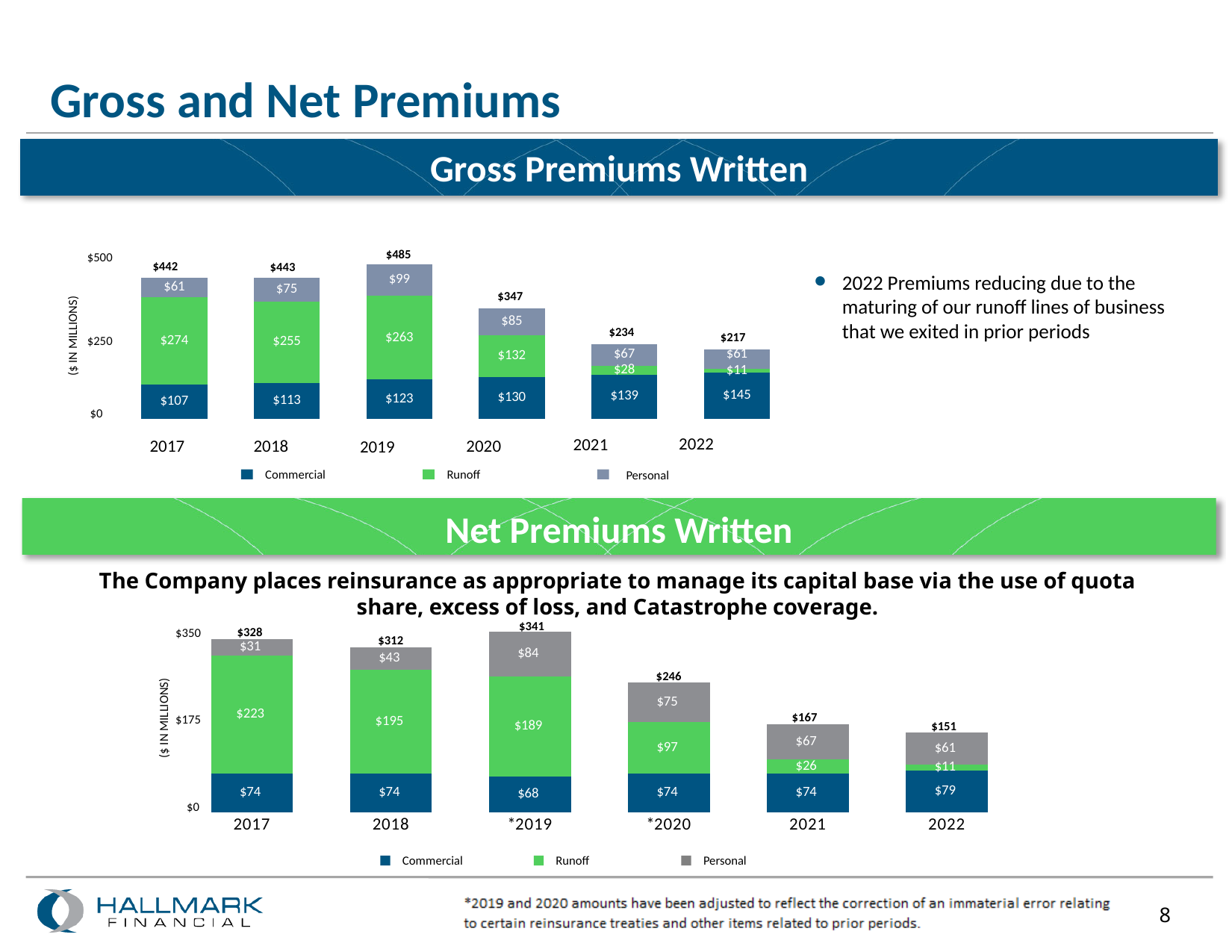
In the Gross Premiums Written chart, what is the Commercial value for 2019? $123 In the Gross Premiums Written chart, how many years are shown on the x axis? 6 In the Gross Premiums Written chart, do the bar totals rise or fall from 2019 to 2022? Fall In the Net Premiums Written chart, what is the Personal value for *2019? $84 In the Net Premiums Written chart, which year has the lowest total? 2022 In the Net Premiums Written chart, what is the total of the stacked bar for 2021? $167 In the Net Premiums Written chart, is the Runoff value larger for 2018 or for *2020? 2018 In the Gross Premiums Written chart, what is the total of the stacked bar for 2020? $347 In the Gross Premiums Written chart, what is the difference between the Runoff values for 2017 and 2022? $263 In the Gross Premiums Written chart, which year has the highest total? 2019 What kind of chart is the Net Premiums Written chart? Stacked bar chart In the Net Premiums Written chart, how many series does the legend list? 3